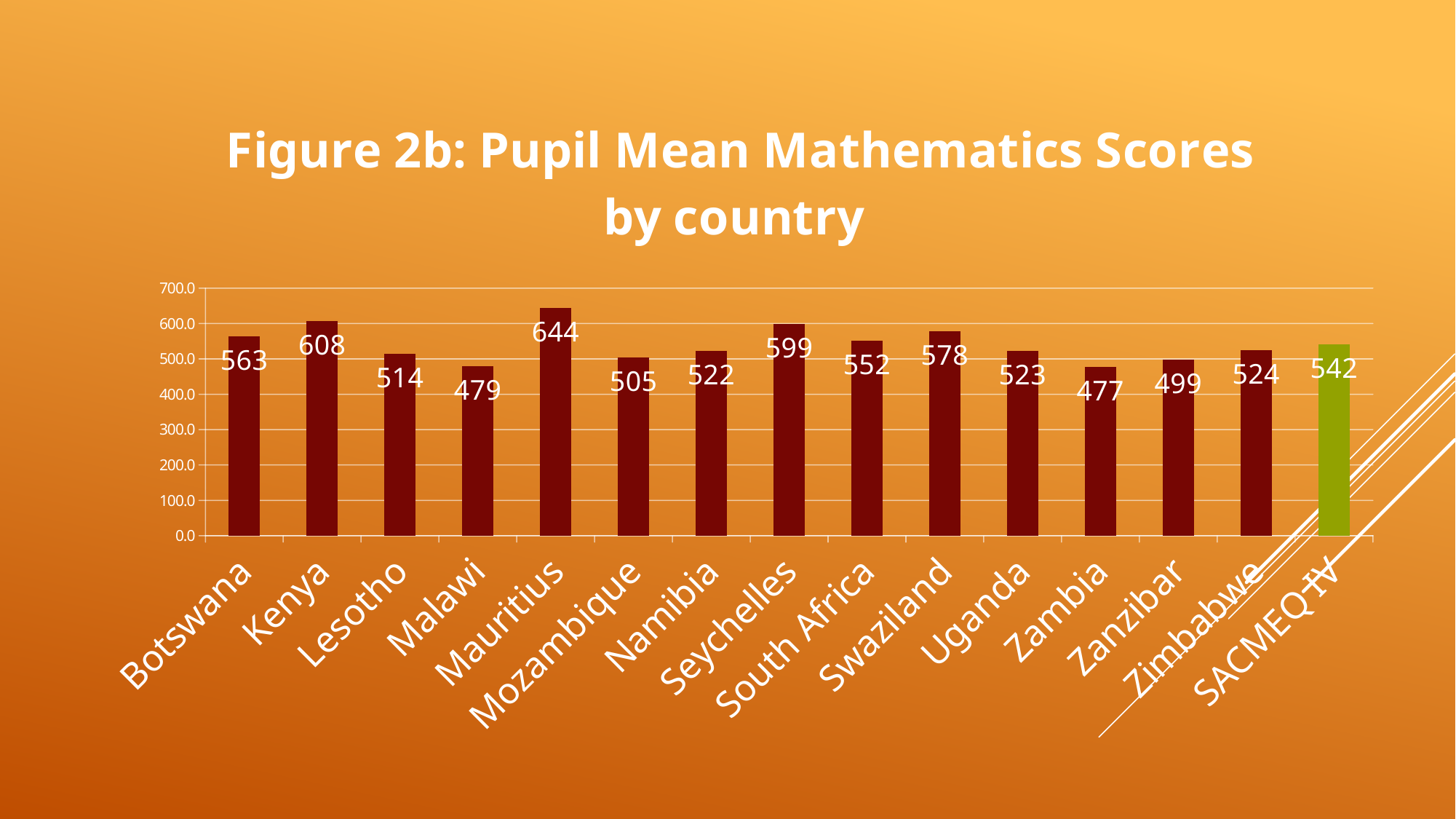
What is the difference between the scores for Mauritius and Malawi? 165 Which has a higher score, Seychelles or Swaziland? Seychelles Is the value for Botswana greater or less than 500? greater Which country has the highest pupil mean mathematics score? Mauritius What is the pupil mean mathematics score for Zambia? 477 What kind of chart is shown on the slide? Bar chart What is the title of the chart? Figure 2b: Pupil Mean Mathematics Scores by country What is the pupil mean mathematics score for Kenya? 608 What is the value shown for SACMEQ IV? 542 Which country has the lowest pupil mean mathematics score? Zambia How many bars are plotted in the chart? 15 Which bar is coloured green rather than dark red? SACMEQ IV